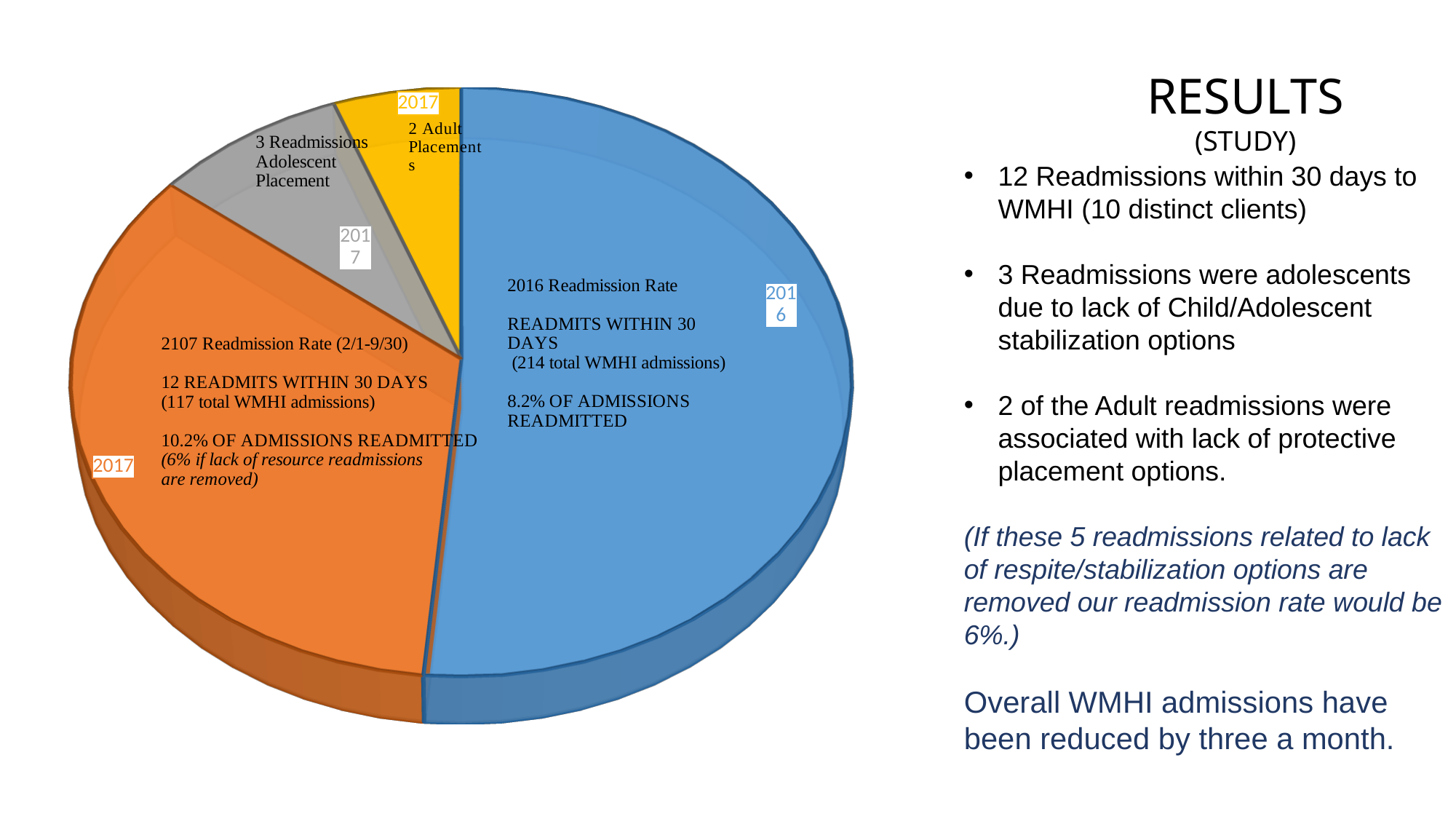
What percentage of admissions were readmitted in 2017 according to the pie chart? 10.2% Which slice of the pie chart is the smallest? 2 Adult Placements (yellow 2017 slice) How many slices does the pie chart have? 4 How many readmits within 30 days are shown for 2017 in the pie chart? 12 What is the difference between the total WMHI admissions in 2016 and 2017 as shown in the pie chart? 97 Which slice is larger, the 2016 slice or the orange 2017 slice? 2016 How many total WMHI admissions are listed for 2016 in the pie chart? 214 Which slice of the pie chart is the largest? 2016 (blue slice) What label is shown on the gray slice of the pie chart? 3 Readmissions Adolescent Placement What was the 2016 readmission rate shown in the pie chart? 8.2% What kind of chart is shown on the slide? Pie chart How many total WMHI admissions are listed for 2017 in the pie chart? 117